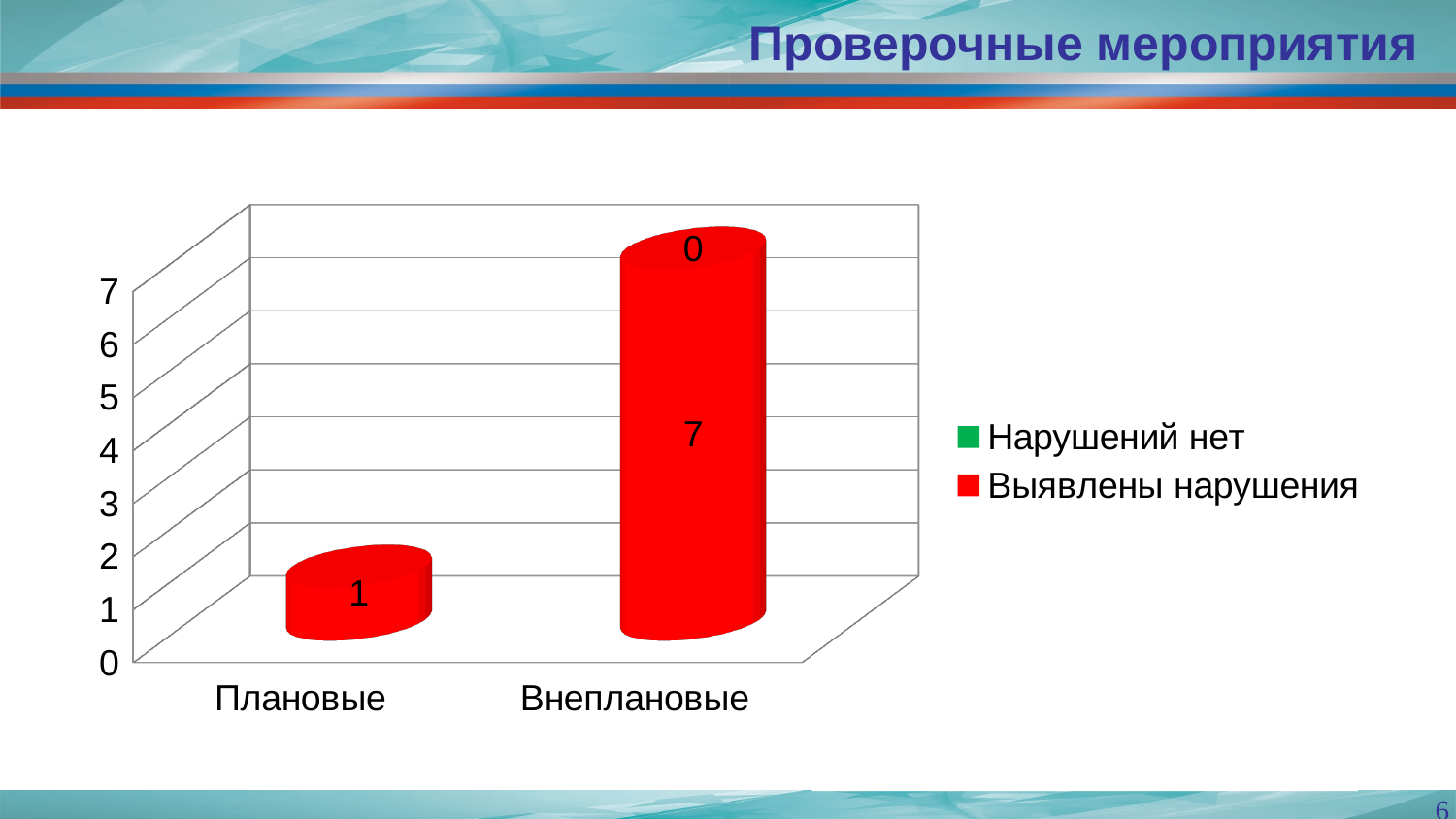
Which category has the highest value for "Выявлены нарушения"? Внеплановые How many categories are shown on the x axis of the chart? 2 What kind of chart is shown on the slide? bar chart What is the value of "Выявлены нарушения" for the "Внеплановые" category? 7 What is the difference between the "Выявлены нарушения" values for "Внеплановые" and "Плановые"? 6 How many series does the chart legend list? 2 Which category has the lowest value for "Выявлены нарушения"? Плановые Which is larger: the "Выявлены нарушения" value for "Плановые" or for "Внеплановые"? Внеплановые What colour represents the "Выявлены нарушения" series in the legend? red Is the "Выявлены нарушения" value for "Внеплановые" greater or less than 5? greater What is the value of "Выявлены нарушения" for the "Плановые" category? 1 What is the value of "Нарушений нет" for the "Внеплановые" category? 0